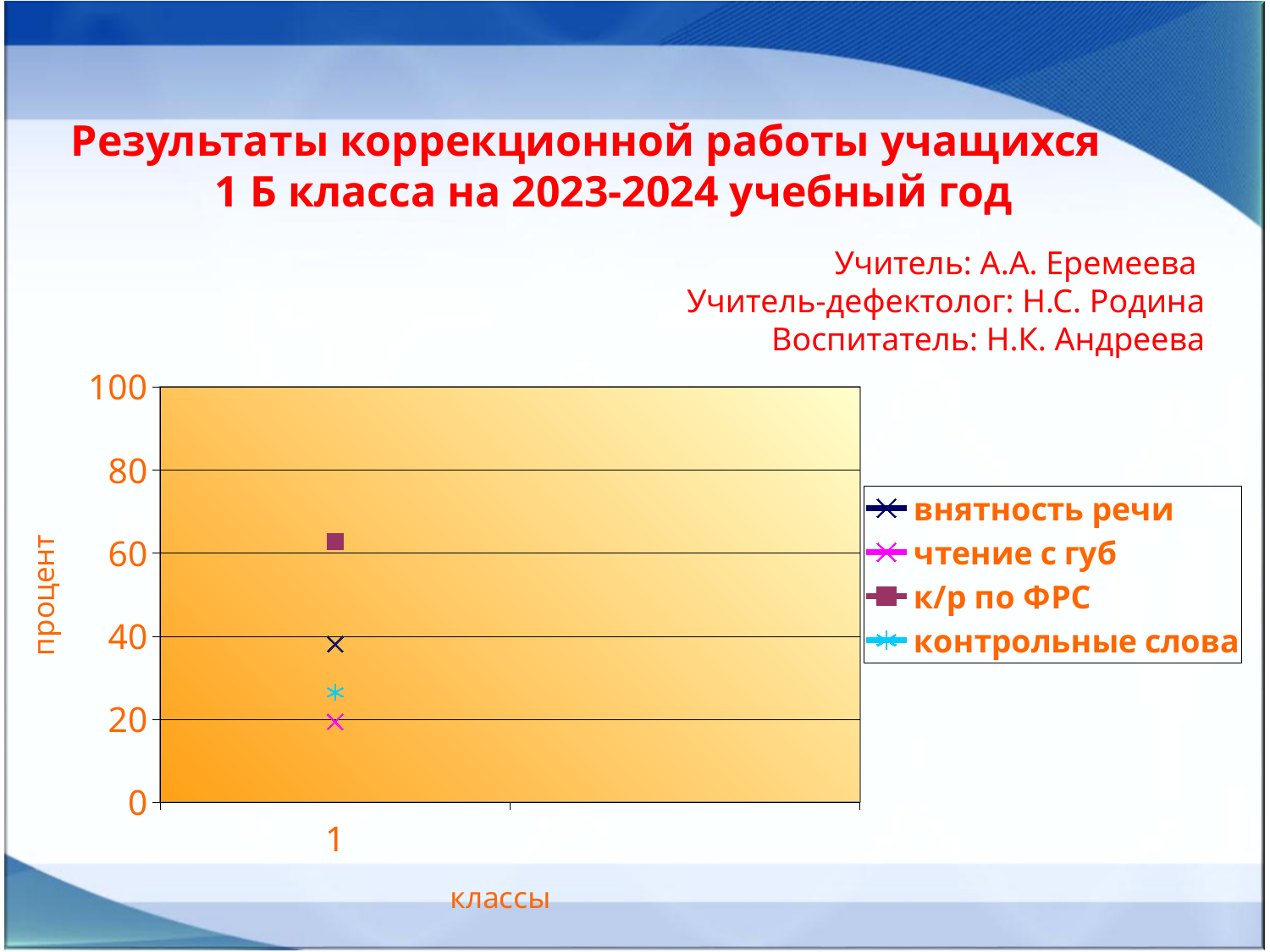
What is the label of the vertical axis? процент What kind of chart is shown on the slide? line chart Which is larger, the value for чтение с губ or the value for к/р по ФРС? к/р по ФРС Which series has the lowest value for class 1? чтение с губ Is the value for внятность речи greater or less than 40? less Is the value for к/р по ФРС greater or less than 60? greater Is the value for к/р по ФРС greater or less than 80? less How many series does the legend list? 4 Which is larger, the value for внятность речи or the value for контрольные слова? внятность речи Which series has the highest value for class 1? к/р по ФРС How many categories are shown on the x axis? 1